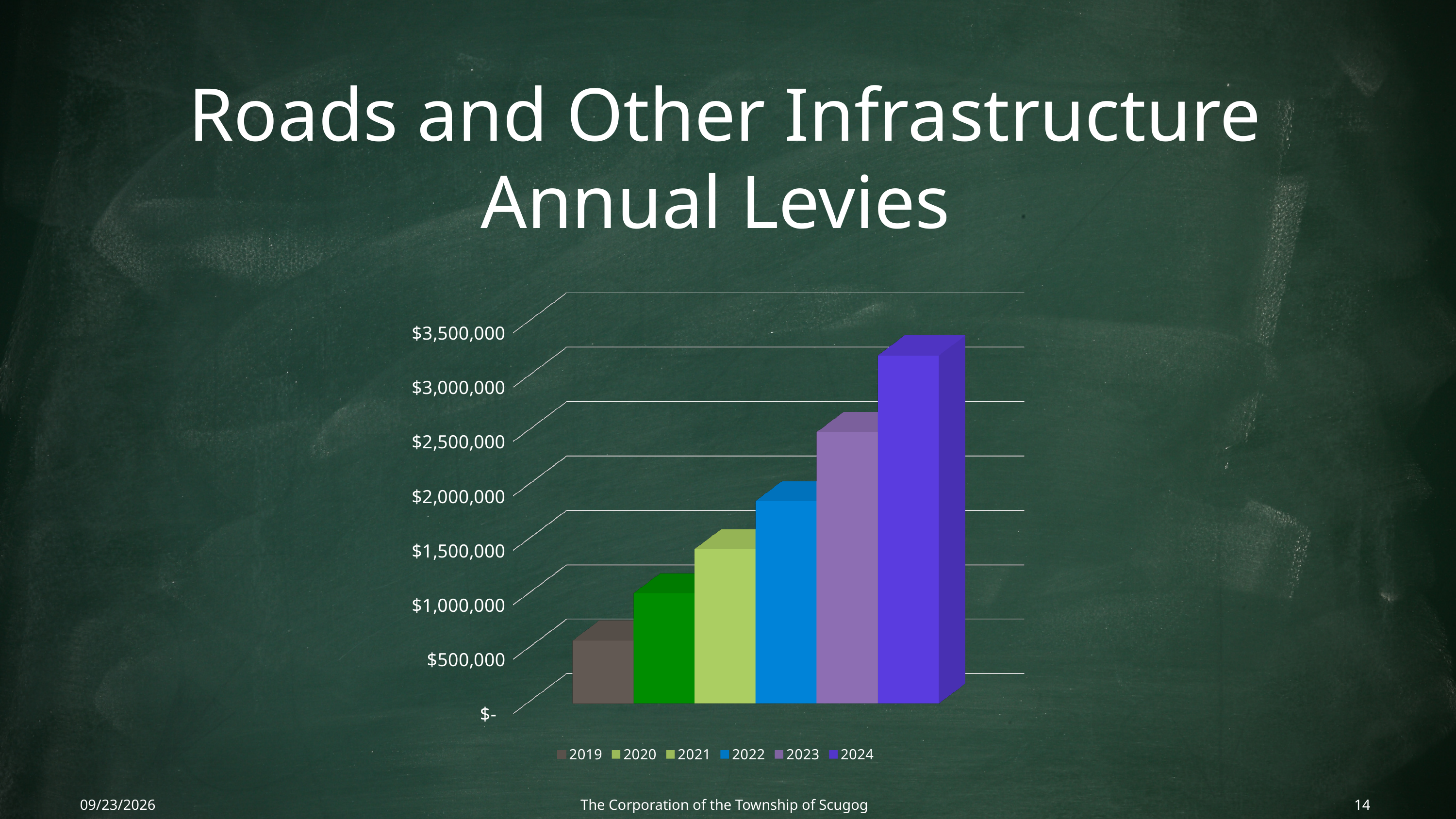
Is the value for 2022 greater or less than $1,500,000? greater How many bars are plotted in the chart? 6 How many entries does the chart's legend list? 6 Is the value for 2019 greater or less than $1,000,000? less Is the value for 2024 greater or less than $2,500,000? greater Which is larger, the levy for 2023 or the levy for 2021? 2023 Which year has the lowest annual levy in the chart? 2019 What is the highest value labelled on the chart's vertical axis? $3,500,000 Which year has the highest annual levy in the chart? 2024 What kind of chart is shown on the slide? bar chart Do the levy values rise or fall from 2019 to 2024? rise